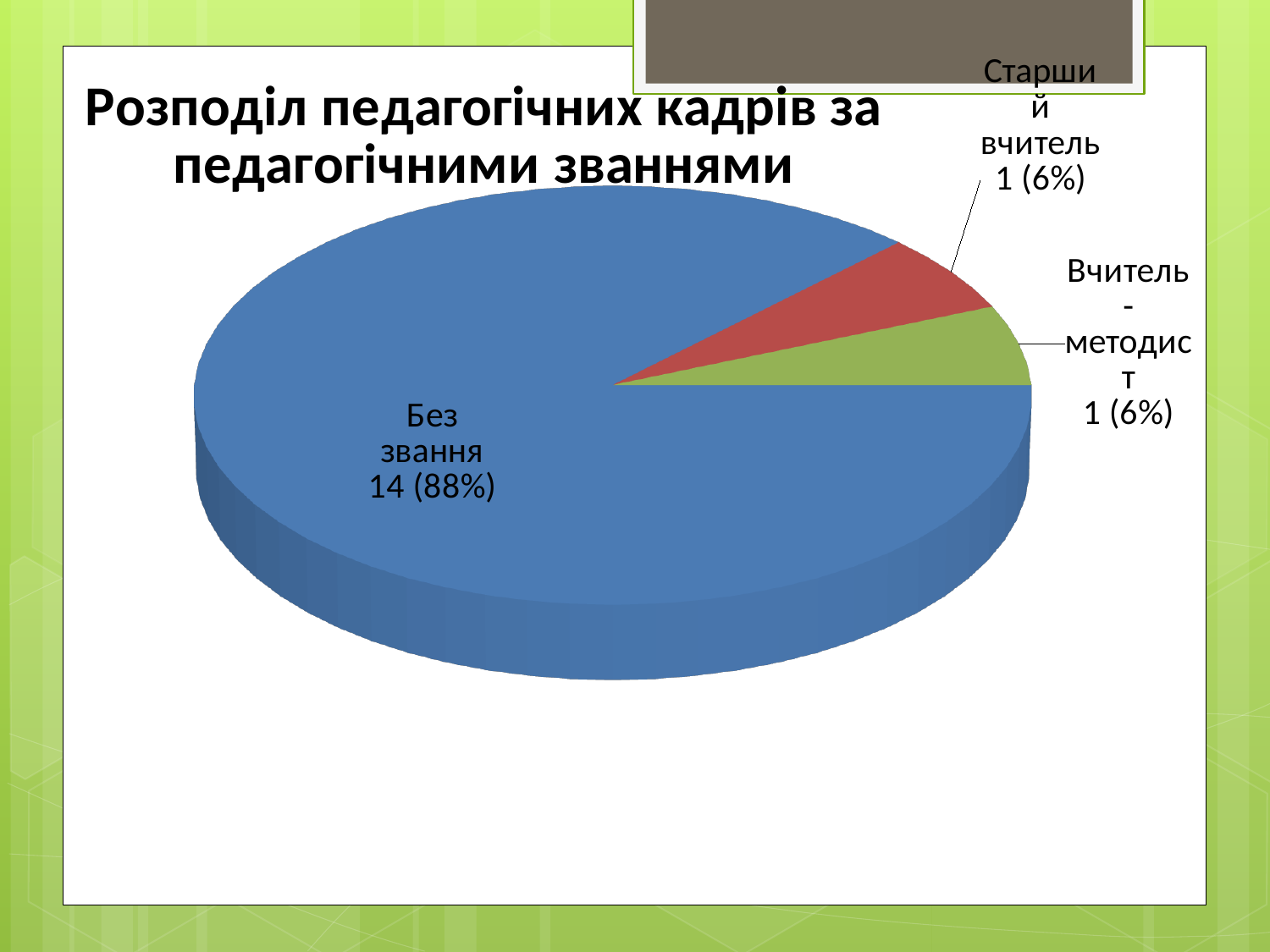
What share of the pie does "Без звання" represent? 88% What share of the pie does "Вчитель-методист" represent? 6% What value is shown for the slice "Старший вчитель"? 1 (6%) What is the difference between the count for "Без звання" and the count for "Старший вчитель"? 13 Which category has the largest slice of the pie? Без звання What value is shown for the slice "Вчитель-методист"? 1 (6%) What kind of chart is shown on the slide? Pie chart What colour is the slice for "Без звання"? Blue How many slices does the pie chart have? 3 Which is larger, the value for "Без звання" or the value for "Старший вчитель"? Без звання What value is shown for the slice "Без звання"? 14 (88%) What is the title of the chart? Розподіл педагогічних кадрів за педагогічними званнями